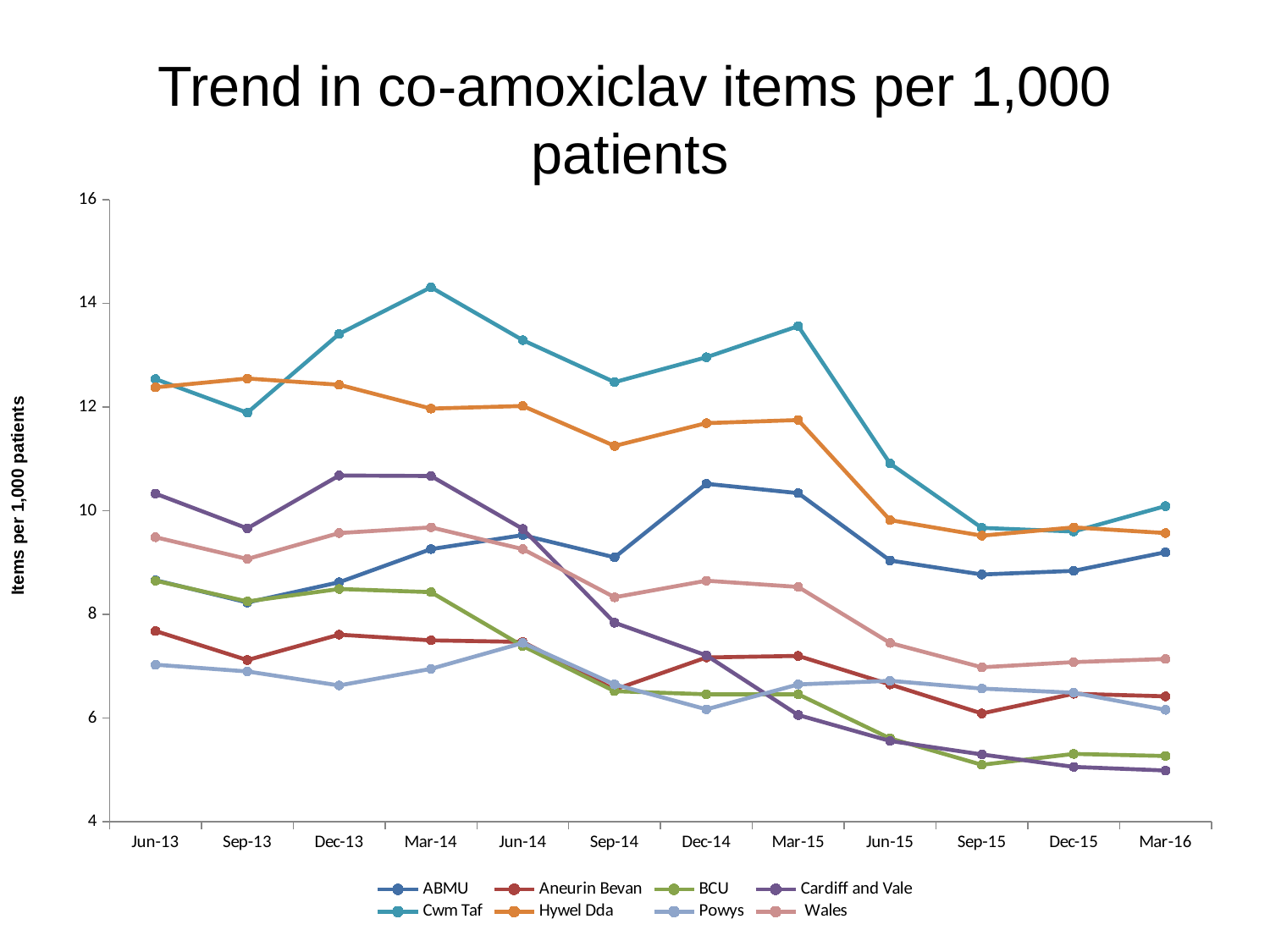
Which series has the highest value at Mar-14? Cwm Taf Is the value for ABMU at Dec-14 greater or less than 10? greater Which series has the highest value at Sep-13? Hywel Dda Which is larger at Dec-14, the value for ABMU or the value for Wales? ABMU How many series does the legend list? 8 What kind of chart is shown on the slide? line chart Is the value for Cardiff and Vale at Mar-16 greater or less than 6? less What is the title of the y axis? Items per 1,000 patients Does the Wales line rise or fall overall from Jun-13 to Mar-16? fall Is the value for Cwm Taf at Mar-14 greater or less than 14? greater How many time points are shown on the x axis? 12 Which series has the lowest value at Mar-16? Cardiff and Vale